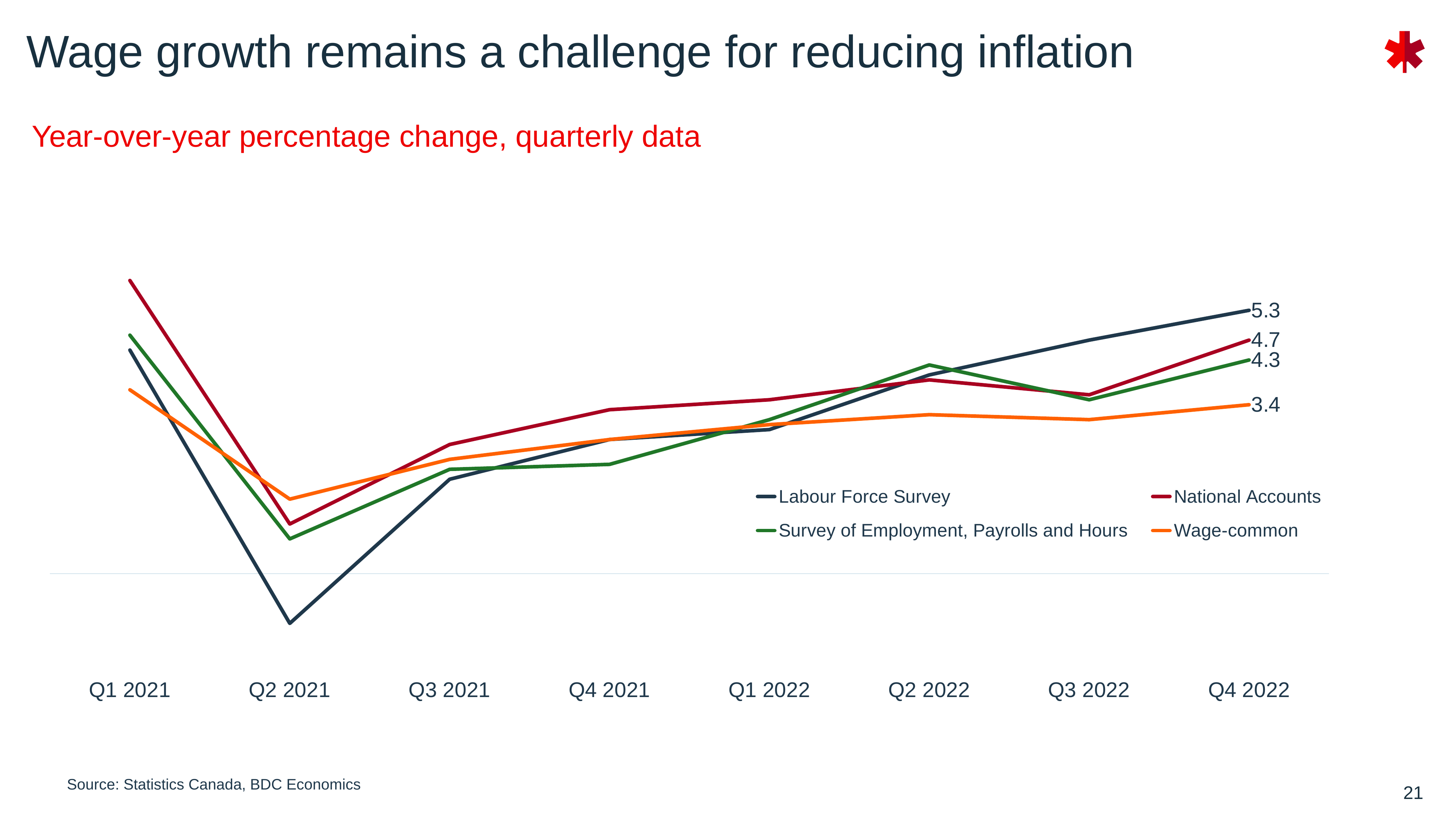
What kind of chart is shown on the slide? Line chart What is the difference between the Labour Force Survey and Wage-common values in Q4 2022? 1.9 How many quarters are shown on the x axis? 8 What is the Q4 2022 value for the Labour Force Survey series? 5.3 Does the Labour Force Survey series rise or fall from Q2 2021 to Q4 2022? Rise Which series has the highest value in Q4 2022? Labour Force Survey In Q2 2021, which series is lower: Labour Force Survey or Wage-common? Labour Force Survey What is the Q4 2022 value for the Survey of Employment, Payrolls and Hours series? 4.3 What is the Q4 2022 value for the Wage-common series? 3.4 What is the Q4 2022 value for the National Accounts series? 4.7 How many series does the legend list? 4 Which series has the lowest value in Q4 2022? Wage-common